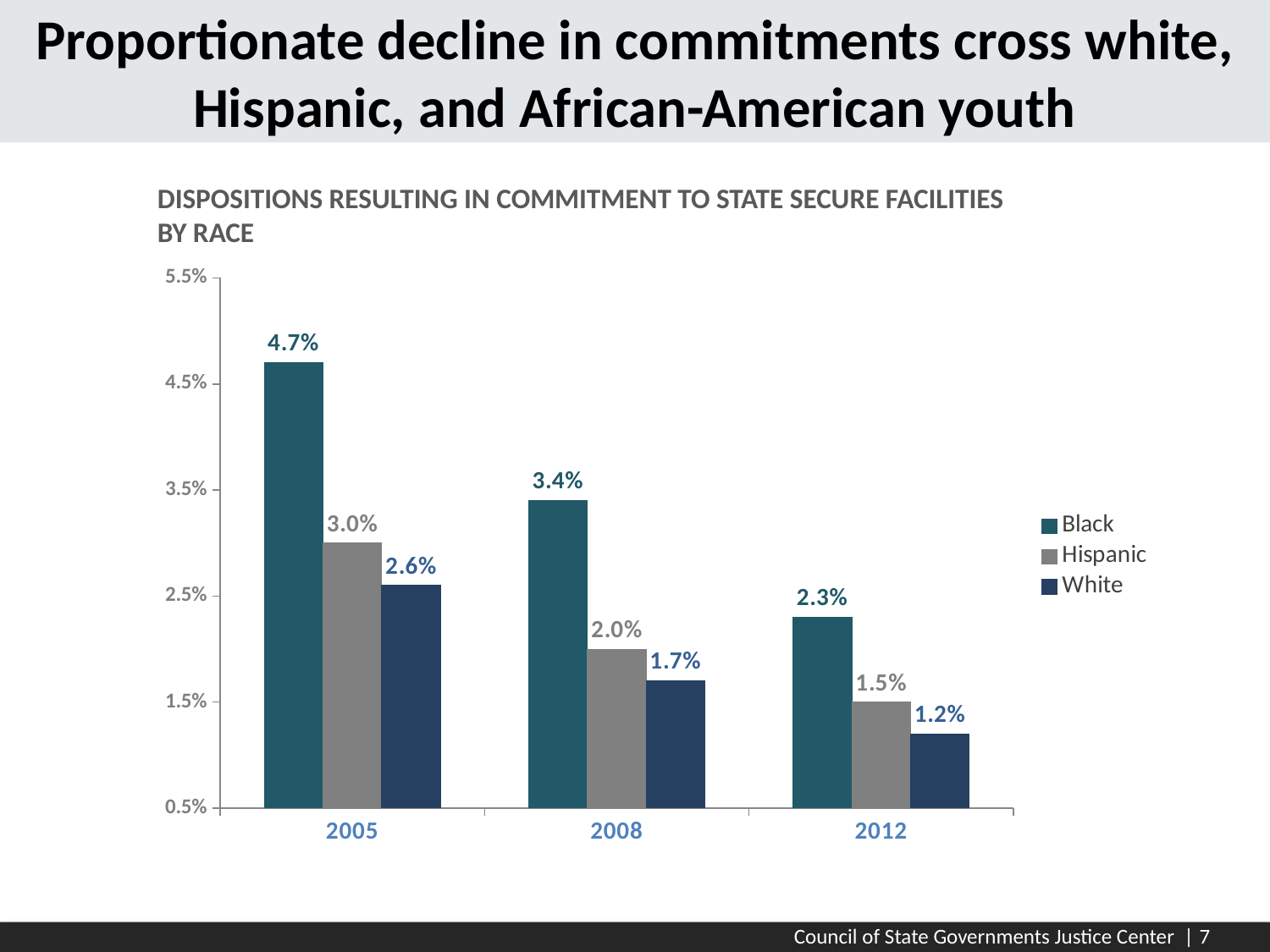
What is the value for Hispanic in 2008? 2.0% Which year has the highest value for the Black series? 2005 What is the difference between the Black value in 2005 and the Black value in 2012? 2.4% Is the value for Black in 2008 greater or less than 2.5%? greater What is the value for Black in 2005? 4.7% Which is larger, the Hispanic value in 2005 or the White value in 2008? Hispanic value in 2005 Do the values for the Hispanic series rise or fall from 2005 to 2012? fall What kind of chart is shown? bar chart Which year has the lowest value for the White series? 2012 How many years are shown on the x axis? 3 How many series does the legend list? 3 What is the value for White in 2012? 1.2%